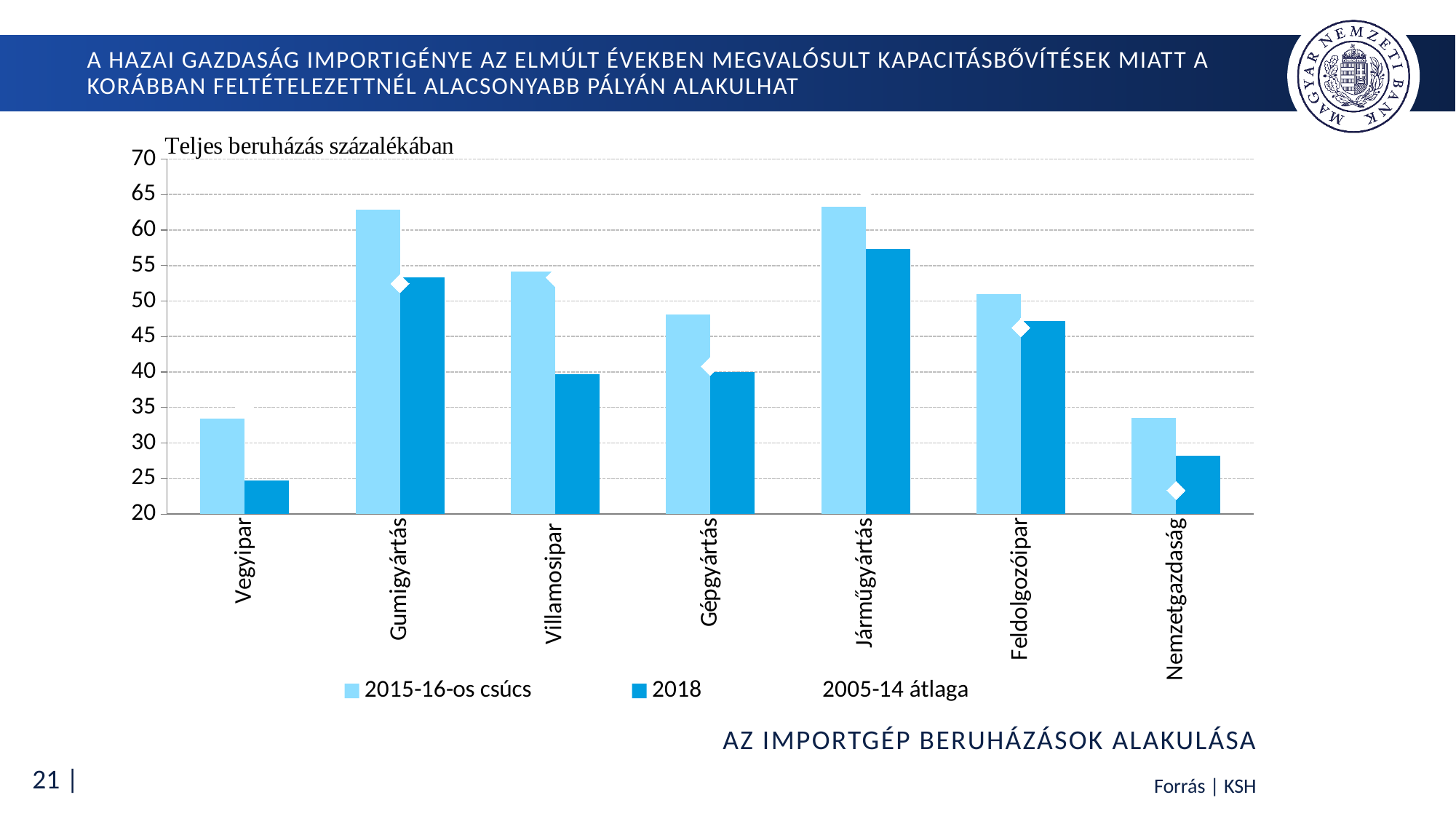
What kind of chart is shown on the slide? bar chart How many series does the chart legend list? 3 Is the 2018 value for Járműgyártás greater or less than 55? greater Which category has the highest value for the 2018 series? Járműgyártás How many industry categories are shown on the x axis of the chart? 7 Which is larger for the 2015-16-os csúcs series: Vegyipar or Gépgyártás? Gépgyártás Is the 2018 value for Villamosipar greater or less than 45? less Is the 2015-16-os csúcs value for Gumigyártás greater or less than 60? greater Which category has the lowest value for the 2018 series? Vegyipar Which is larger for the 2018 series: Gumigyártás or Feldolgozóipar? Gumigyártás What is the title of the chart shown on the slide? Az importgép beruházások alakulása